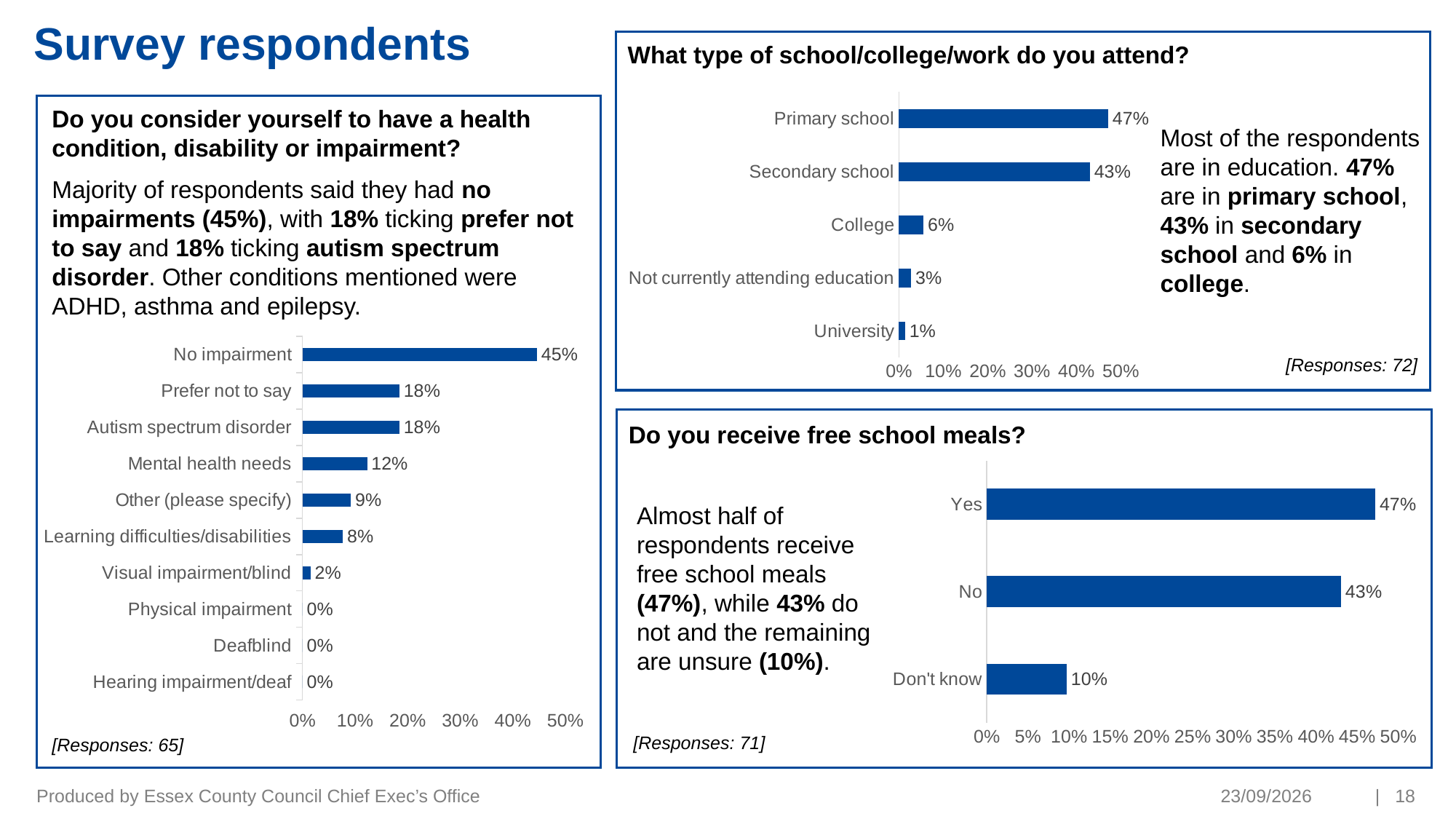
In the 'Do you consider yourself to have a health condition, disability or impairment?' chart, which category has the highest value? No impairment In the 'What type of school/college/work do you attend?' chart, what is the value for College? 6% In the 'Do you consider yourself to have a health condition, disability or impairment?' chart, what is the difference between No impairment and Prefer not to say? 27% In the 'Do you receive free school meals?' chart, what is the value for Don't know? 10% In the 'What type of school/college/work do you attend?' chart, how many categories are shown? 5 In the 'Do you receive free school meals?' chart, what is the difference between Yes and No? 4% In the 'What type of school/college/work do you attend?' chart, which is larger, Primary school or Secondary school? Primary school In the 'Do you consider yourself to have a health condition, disability or impairment?' chart, what is the value for Mental health needs? 12% In the 'Do you consider yourself to have a health condition, disability or impairment?' chart, how many categories are shown? 10 In the 'Do you consider yourself to have a health condition, disability or impairment?' chart, what is the value for Learning difficulties/disabilities? 8% In the 'What type of school/college/work do you attend?' chart, which category has the lowest value? University What kind of chart is the 'Do you receive free school meals?' chart? Bar chart